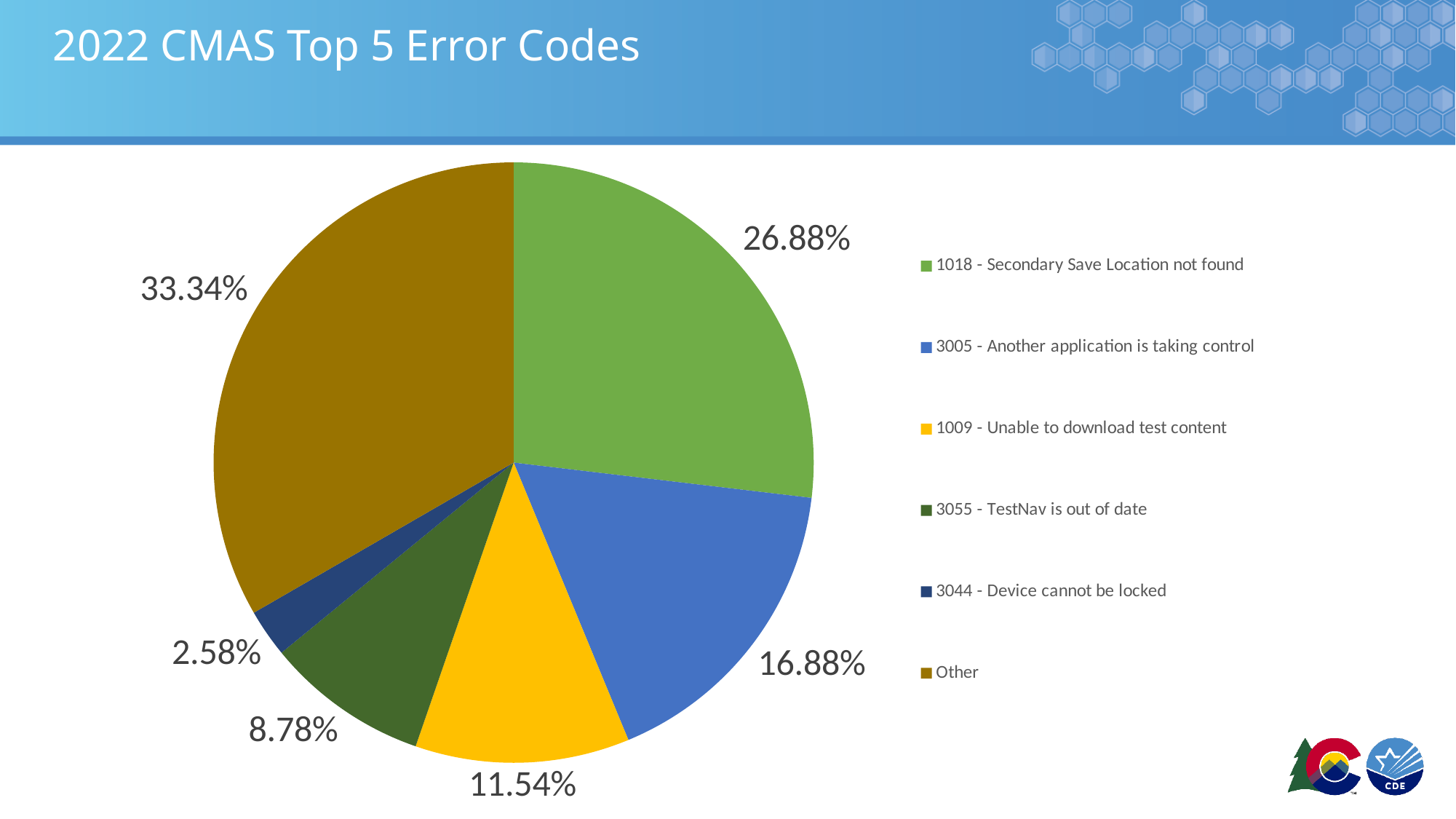
What share of the pie does '1018 - Secondary Save Location not found' represent? 26.88% Which slice of the pie is the smallest? 3044 - Device cannot be locked What share of the pie does '3055 - TestNav is out of date' represent? 8.78% Which is larger: the share for '1009 - Unable to download test content' or '3055 - TestNav is out of date'? 1009 - Unable to download test content How many slices does the pie chart have? 6 What is the title of the slide? 2022 CMAS Top 5 Error Codes What share of the pie does '1009 - Unable to download test content' represent? 11.54% What share of the pie does '3005 - Another application is taking control' represent? 16.88% What kind of chart is shown on the slide? pie chart What share of the pie does '3044 - Device cannot be locked' represent? 2.58% Which slice of the pie is the largest? Other What is the difference between the shares for '1018 - Secondary Save Location not found' and '3005 - Another application is taking control'? 10.00%